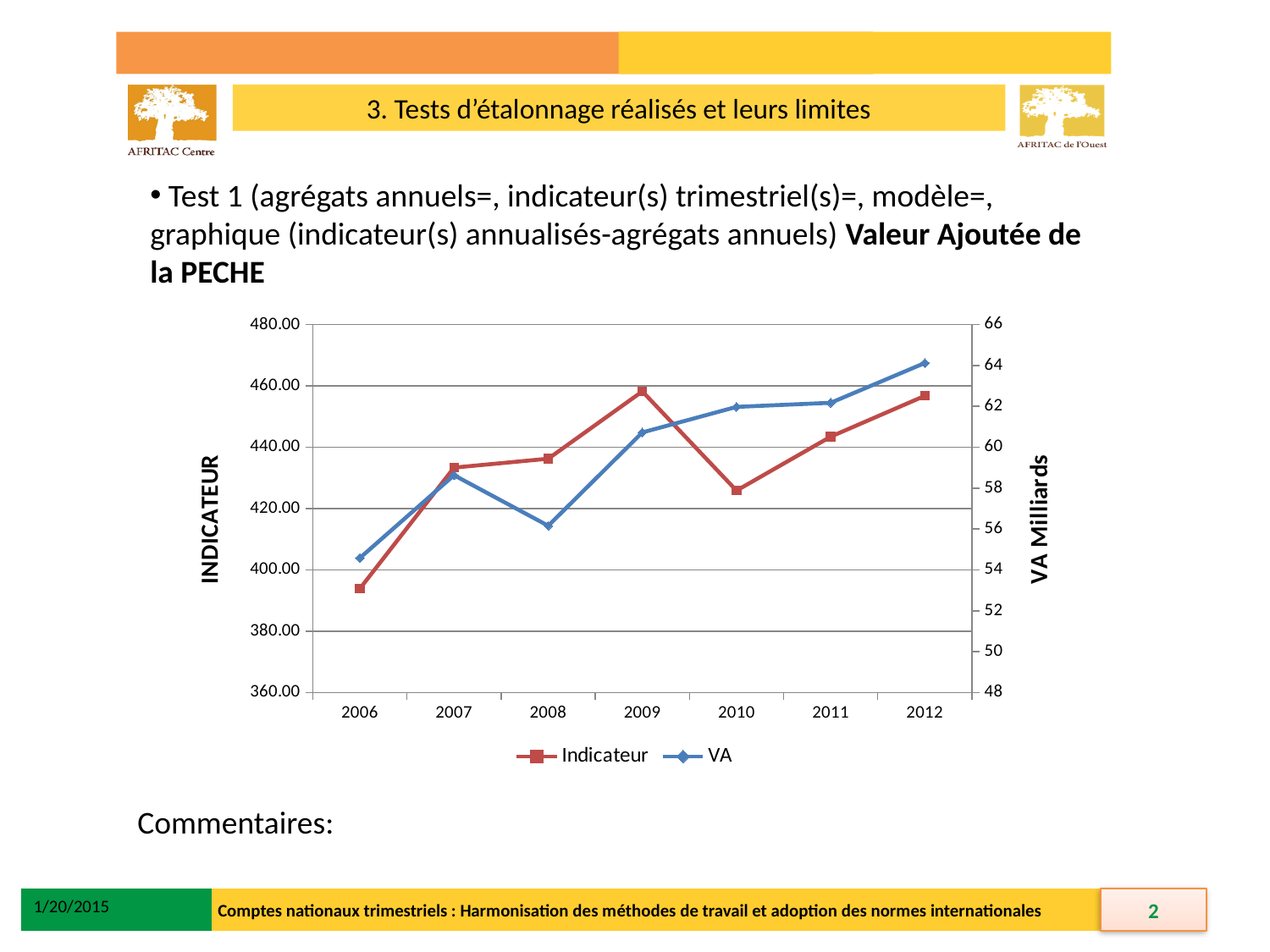
What kind of chart is shown on the slide? line chart Is the VA value for 2008 greater or less than 58? less Is the VA value for 2012 greater or less than 62? greater In which year is the Indicateur series at its lowest? 2006 How many series does the legend list? 2 Is the Indicateur value for 2006 greater or less than 400.00? less In which year is the VA series at its highest? 2012 Which is larger for the Indicateur series, the value for 2009 or the value for 2010? 2009 In which year is the VA series at its lowest? 2006 Does the Indicateur series rise or fall between 2009 and 2010? fall How many years are plotted along the x axis? 7